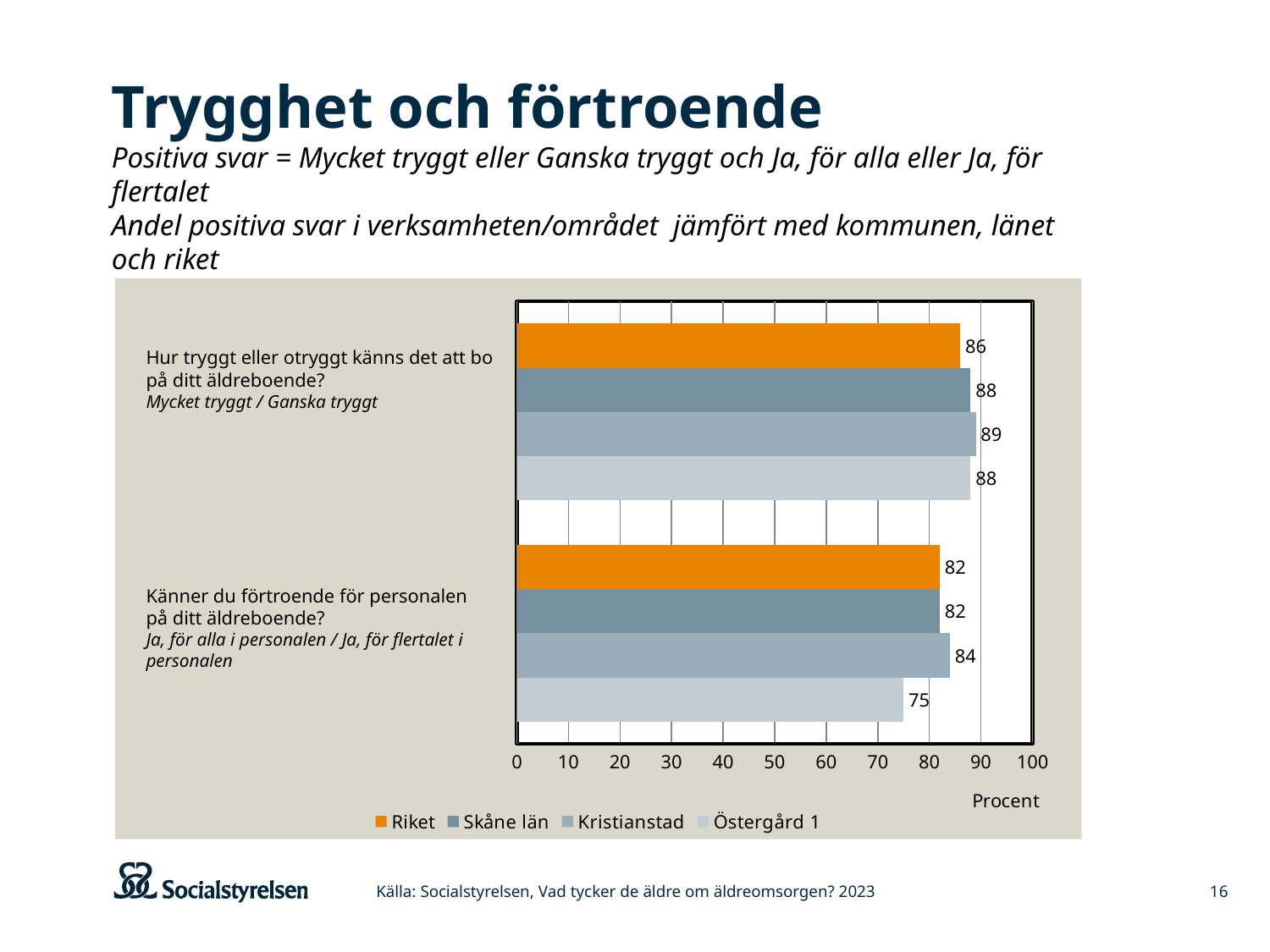
Which series has the highest value on the question "Hur tryggt eller otryggt känns det att bo på ditt äldreboende?"? Kristianstad What kind of chart is shown on the slide? Bar chart Which series has the lowest value on the question "Känner du förtroende för personalen på ditt äldreboende?"? Östergård 1 What is the value for Riket on the question "Känner du förtroende för personalen på ditt äldreboende?"? 82 What is the value for Skåne län on the question "Hur tryggt eller otryggt känns det att bo på ditt äldreboende?"? 88 Which is larger on the question "Hur tryggt eller otryggt känns det att bo på ditt äldreboende?": Riket or Kristianstad? Kristianstad How many series does the legend list? 4 What is the label of the x axis? Procent What is the value for Kristianstad on the question "Hur tryggt eller otryggt känns det att bo på ditt äldreboende?"? 89 What is the value for Östergård 1 on the question "Känner du förtroende för personalen på ditt äldreboende?"? 75 What is the difference between Östergård 1's values on the two questions? 13 What is the difference between Kristianstad and Östergård 1 on the question "Känner du förtroende för personalen på ditt äldreboende?"? 9